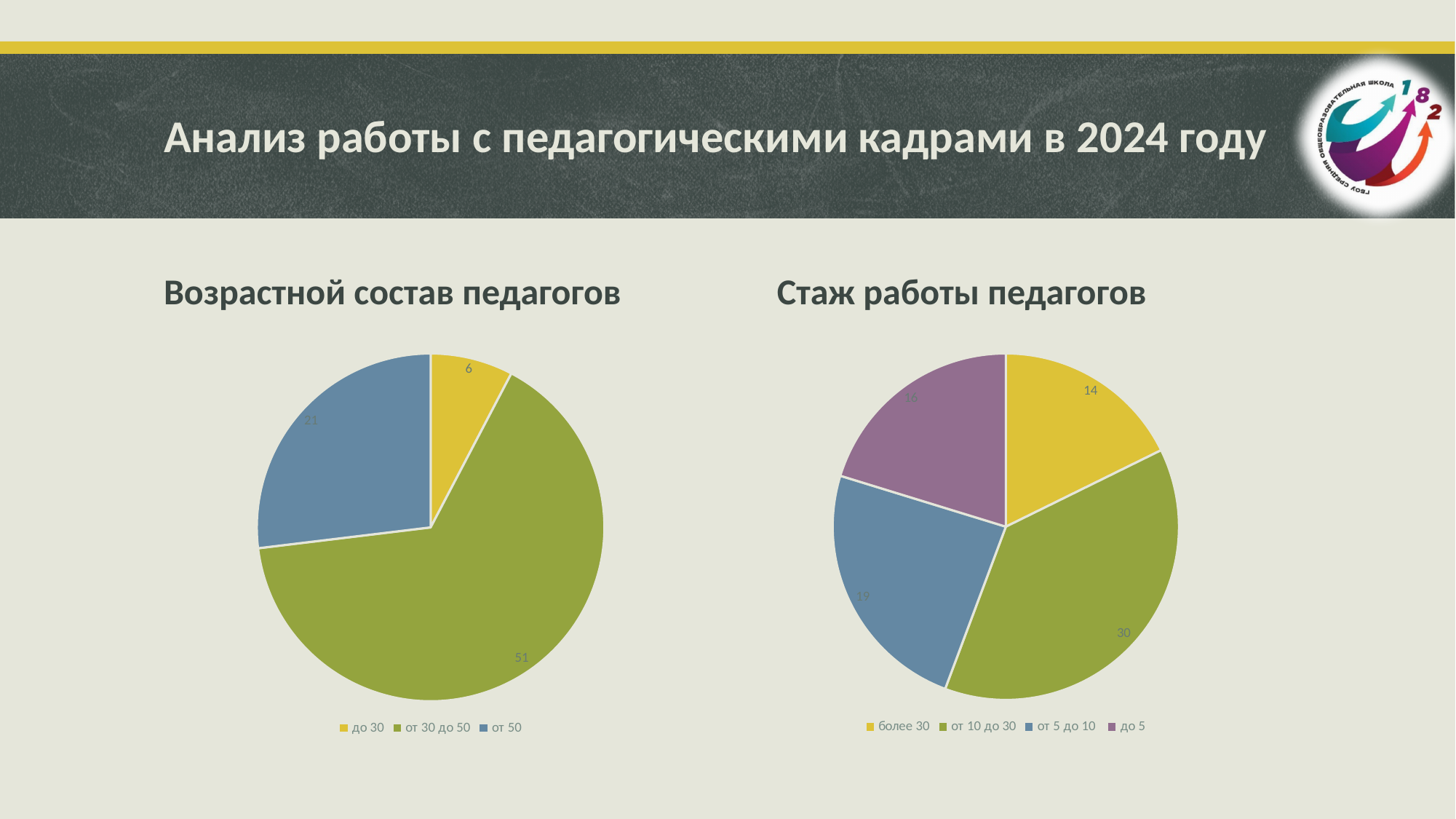
In the "Стаж работы педагогов" chart, which is larger: "более 30" or "от 5 до 10"? от 5 до 10 What kind of chart is "Возрастной состав педагогов"? pie chart In the "Возрастной состав педагогов" chart, what is the value for "до 30"? 6 In the "Возрастной состав педагогов" chart, what is the value for "от 30 до 50"? 51 In the "Возрастной состав педагогов" chart, which category has the smallest slice? до 30 In the "Возрастной состав педагогов" chart, how many categories does the legend list? 3 In the "Стаж работы педагогов" chart, what is the difference between "от 10 до 30" and "более 30"? 16 In the "Возрастной состав педагогов" chart, what is the difference between "от 30 до 50" and "от 50"? 30 In the "Стаж работы педагогов" chart, which category has the largest slice? от 10 до 30 In the "Стаж работы педагогов" chart, how many categories does the legend list? 4 In the "Стаж работы педагогов" chart, what is the value for "до 5"? 16 In the "Стаж работы педагогов" chart, what is the value for "от 5 до 10"? 19